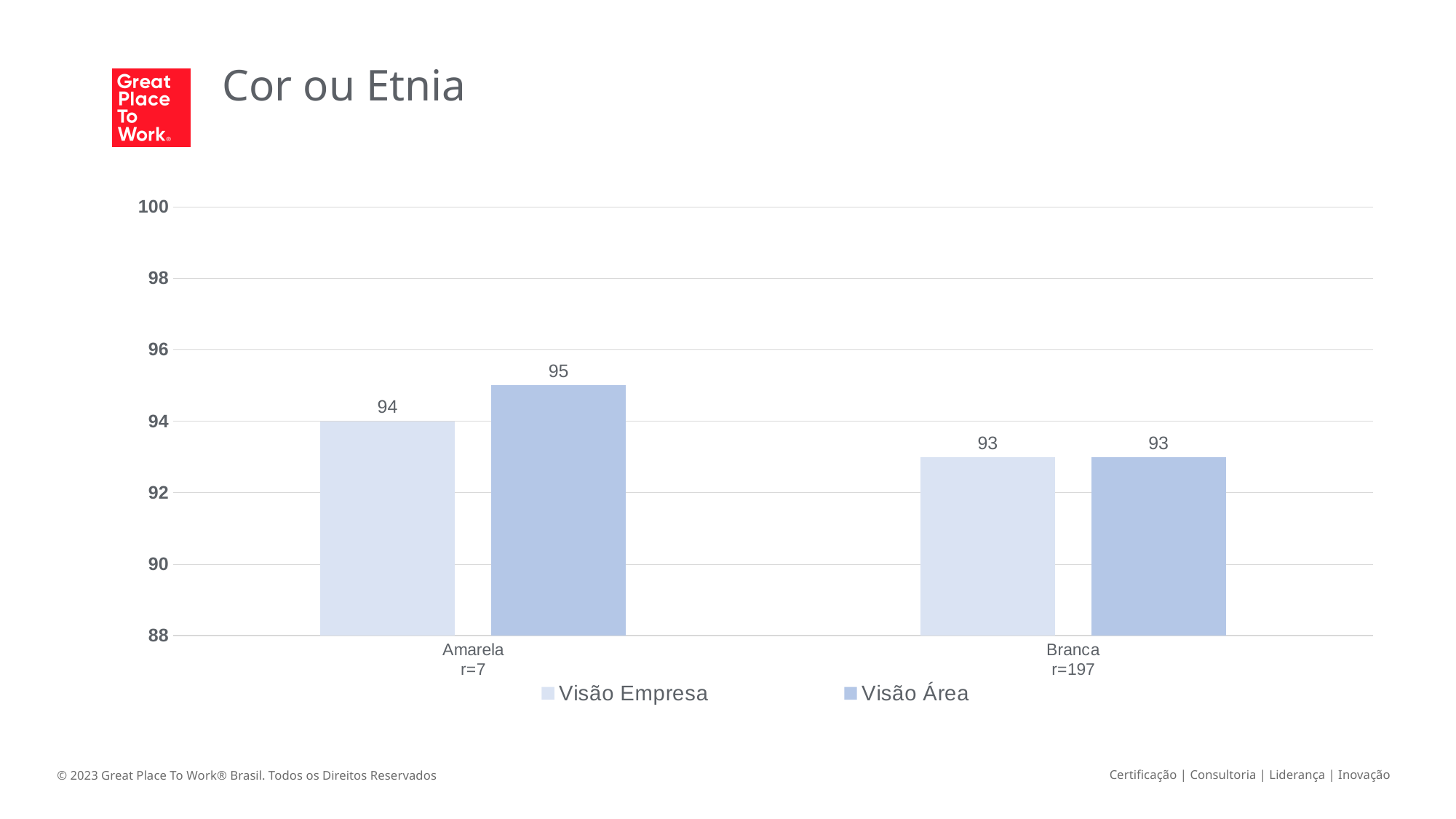
What is the Visão Empresa value for Amarela? 94 What kind of chart is shown on the slide? Bar chart How many series does the legend list? 2 What is the Visão Área value for Amarela? 95 Which is larger for Amarela: Visão Empresa or Visão Área? Visão Área What is the difference between the Visão Área value for Amarela and the Visão Área value for Branca? 2 What is the Visão Empresa value for Branca? 93 What is the title of the slide? Cor ou Etnia Which category has the lowest Visão Empresa value? Branca Which category has the highest Visão Área value? Amarela How many categories are shown on the x axis? 2 What is the Visão Área value for Branca? 93